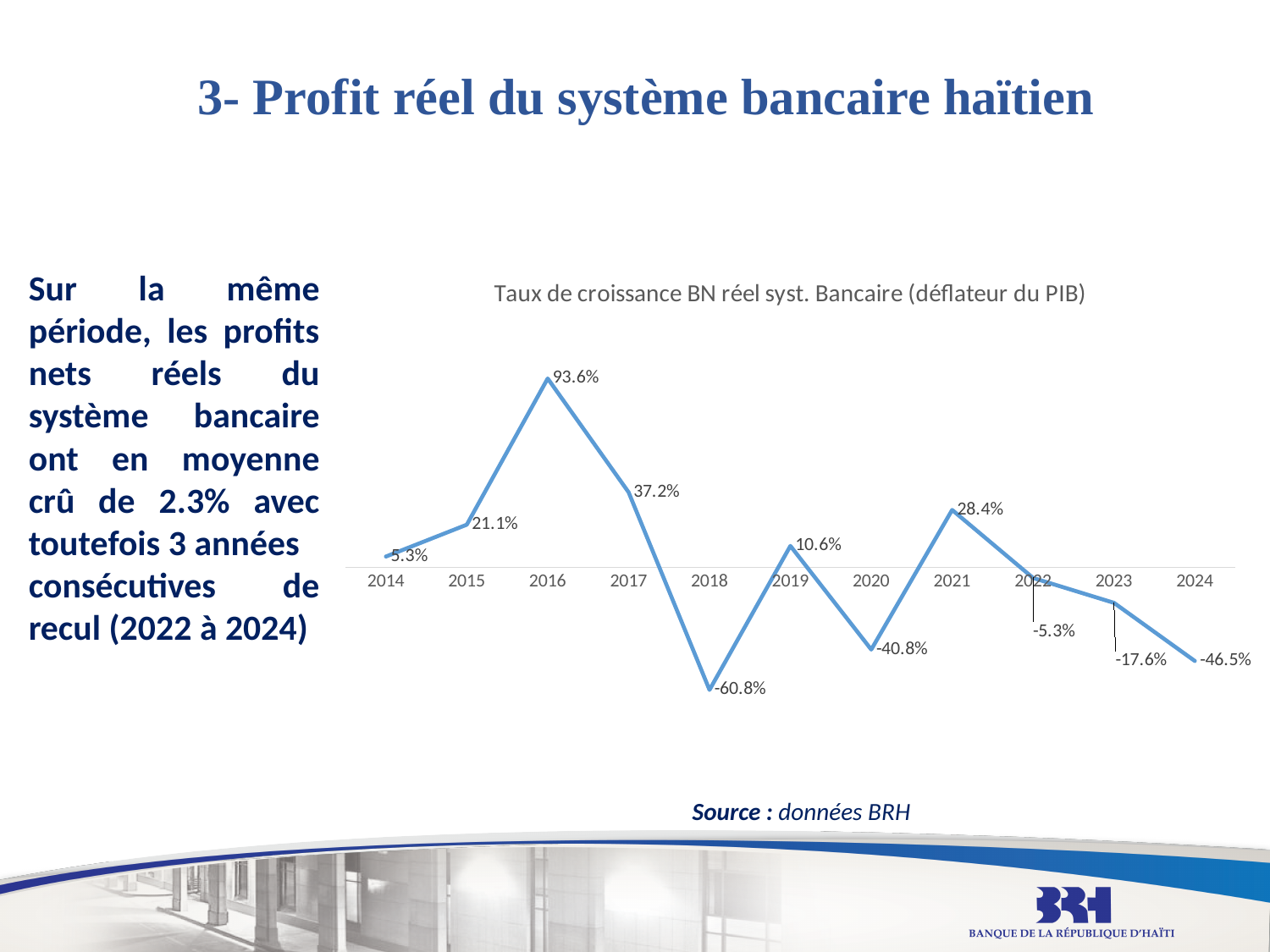
What is the value for 2024? -46.5% Which is larger, the value for 2015 or the value for 2019? 2015 What is the value for 2018? -60.8% What is the value for 2016? 93.6% What type of chart is shown on the slide? Line chart What is the difference between the values for 2016 and 2017? 56.4 percentage points What is the title of the chart? Taux de croissance BN réel syst. Bancaire (déflateur du PIB) Which year has the highest value? 2016 What is the value for 2021? 28.4% Which year has the lowest value? 2018 Do the values rise or fall from 2021 to 2024? Fall How many years are plotted on the chart? 11